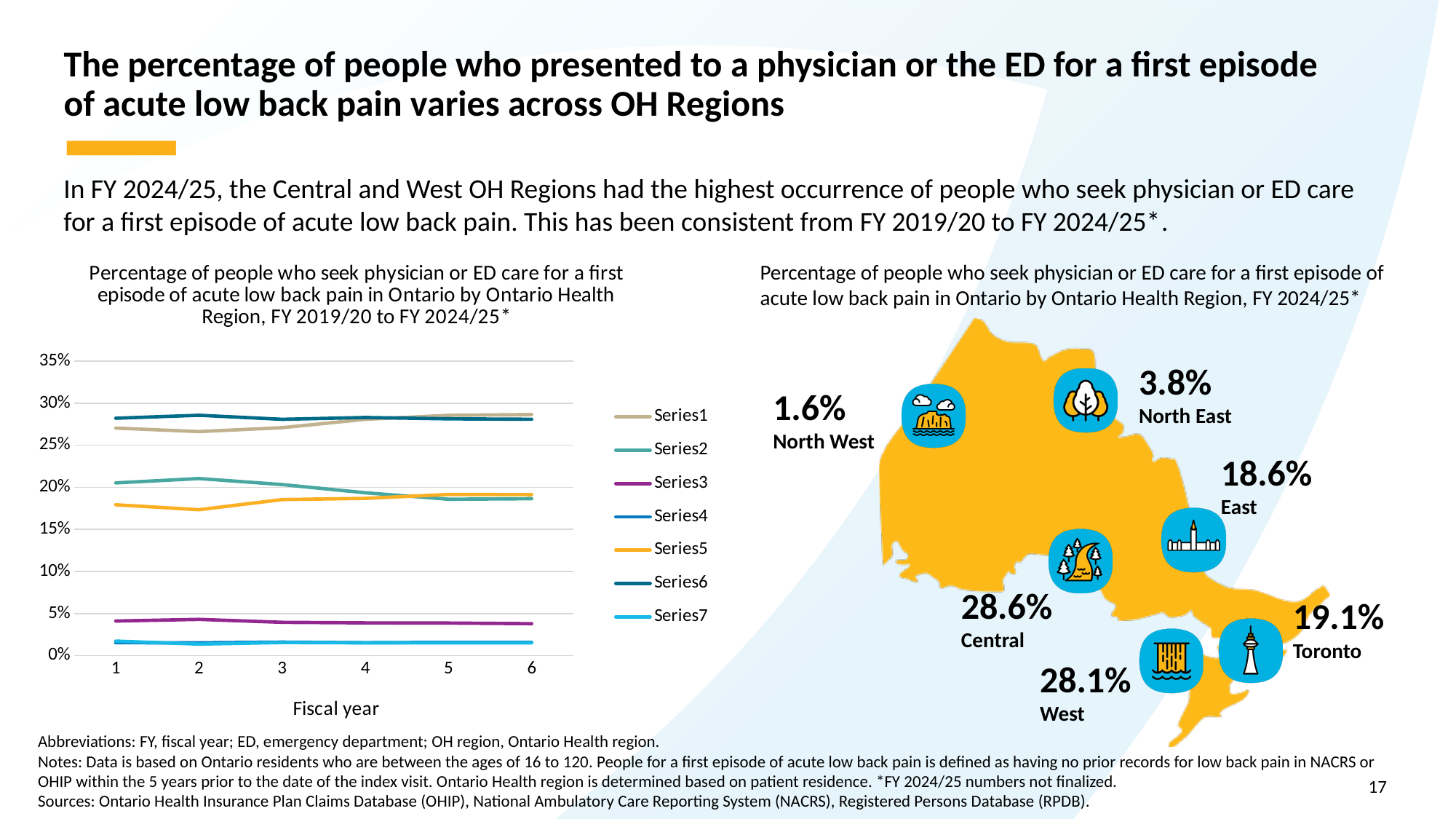
In the left line chart, is the value for Series7 at fiscal year 6 greater or less than 5%? less How many fiscal year points are plotted along the x axis of the left line chart? 6 On the map chart on the right, which region has the highest percentage? Central In the left line chart, does Series2 rise or fall from fiscal year 2 to fiscal year 6? fall On the map chart on the right, what is the difference between the Central and West percentages? 0.5% On the map chart on the right, which region has the larger percentage, East or Toronto? Toronto On the map chart on the right, what is the percentage for the Central region? 28.6% On the map chart on the right, what is the percentage for the North West region? 1.6% How many series does the legend of the left line chart list? 7 What kind of chart is the chart on the left of the slide? line chart In the left line chart, is the value for Series1 at fiscal year 1 greater or less than 25%? greater